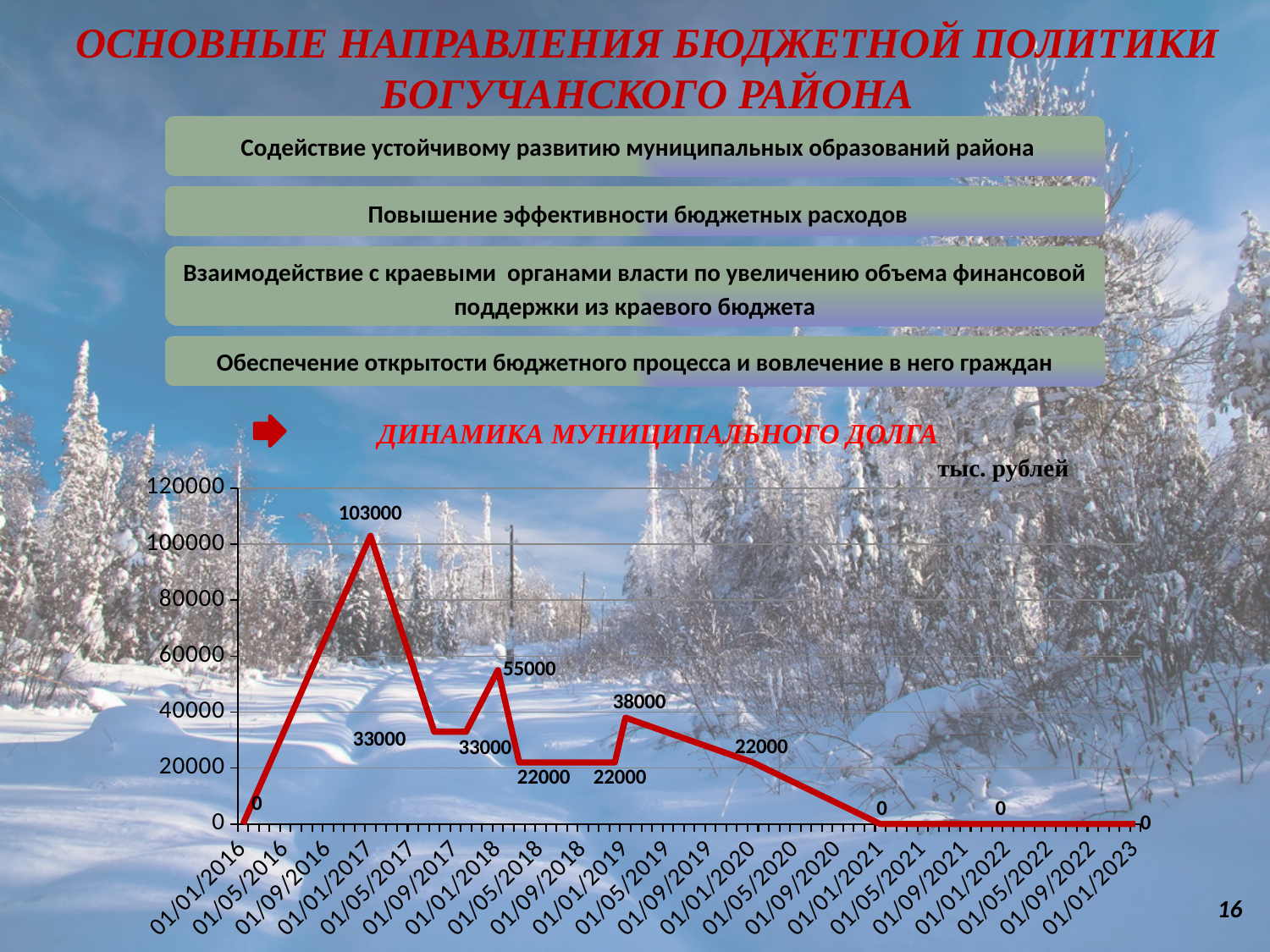
On which date does the municipal debt chart reach its peak? 01/01/2017 By how much does the municipal debt on 01/01/2017 exceed the debt on 01/01/2018? 48000 Which is larger: the municipal debt on 01/01/2018 or on 01/01/2019? 01/01/2018 What is the highest value plotted on the municipal debt chart? 103000 In what units are the values on the municipal debt chart expressed? тыс. рублей What is the value of municipal debt on 01/01/2023? 0 What is the value of municipal debt on 01/01/2016? 0 What is the value of municipal debt on 01/01/2018? 55000 What kind of chart is shown under the heading "ДИНАМИКА МУНИЦИПАЛЬНОГО ДОЛГА"? line chart Does the municipal debt rise or fall between 01/01/2019 and 01/01/2021? fall What is the value of municipal debt on 01/01/2019? 38000